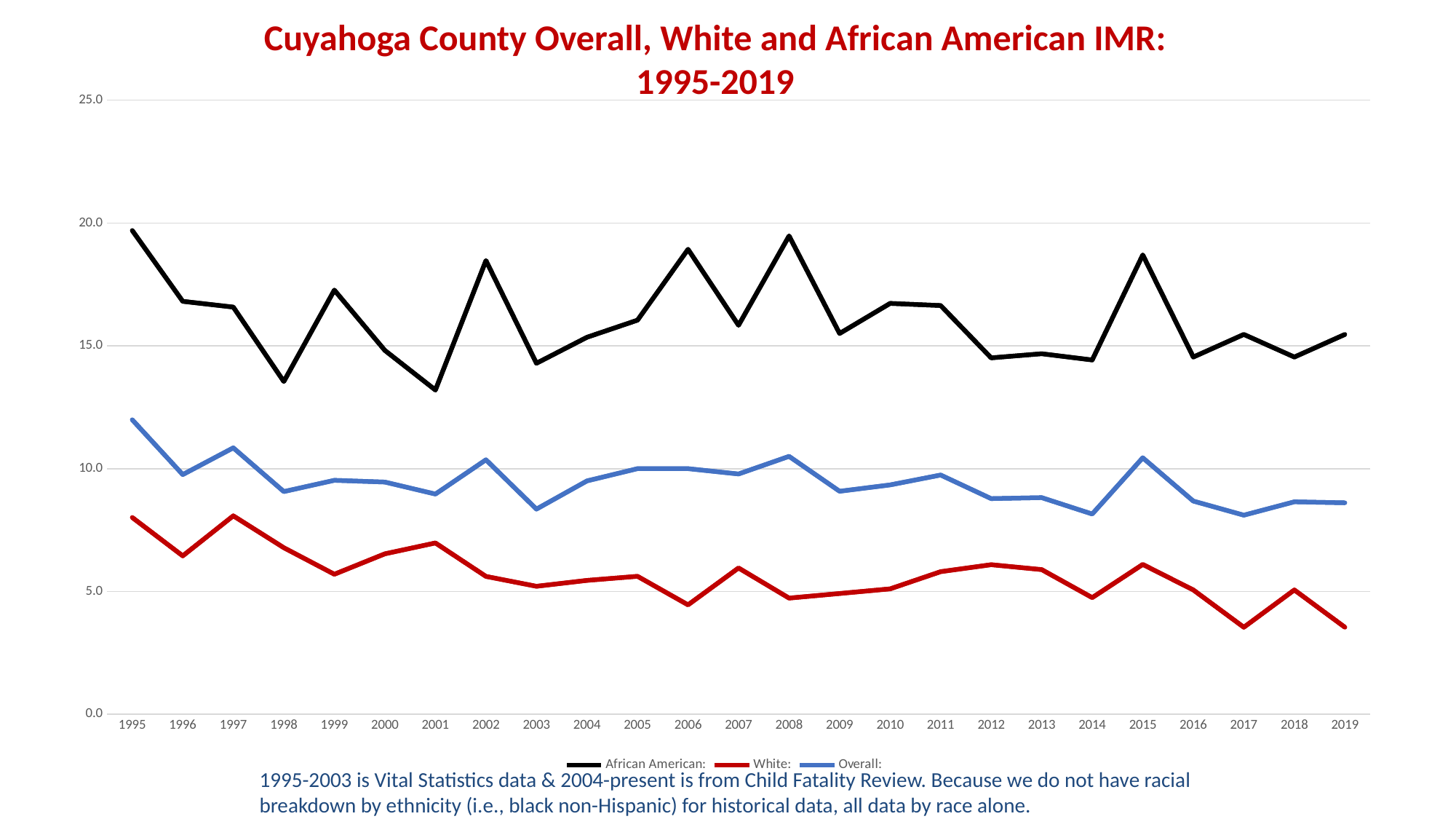
In 2010, which is larger, the African American value or the White value? African American Which series is shown with the black line? African American Is the African American value for 1995 greater or less than 15.0? greater Does the White series generally rise or fall from 1995 to 2019? fall Is the Overall value for 2003 greater or less than 10.0? less How many years are plotted along the x axis? 25 What is the title of the chart? Cuyahoga County Overall, White and African American IMR: 1995-2019 Is the Overall value for 1995 greater or less than 10.0? greater In which year is the Overall series at its highest? 1995 What kind of chart is shown on the slide? line chart How many series does the legend list? 3